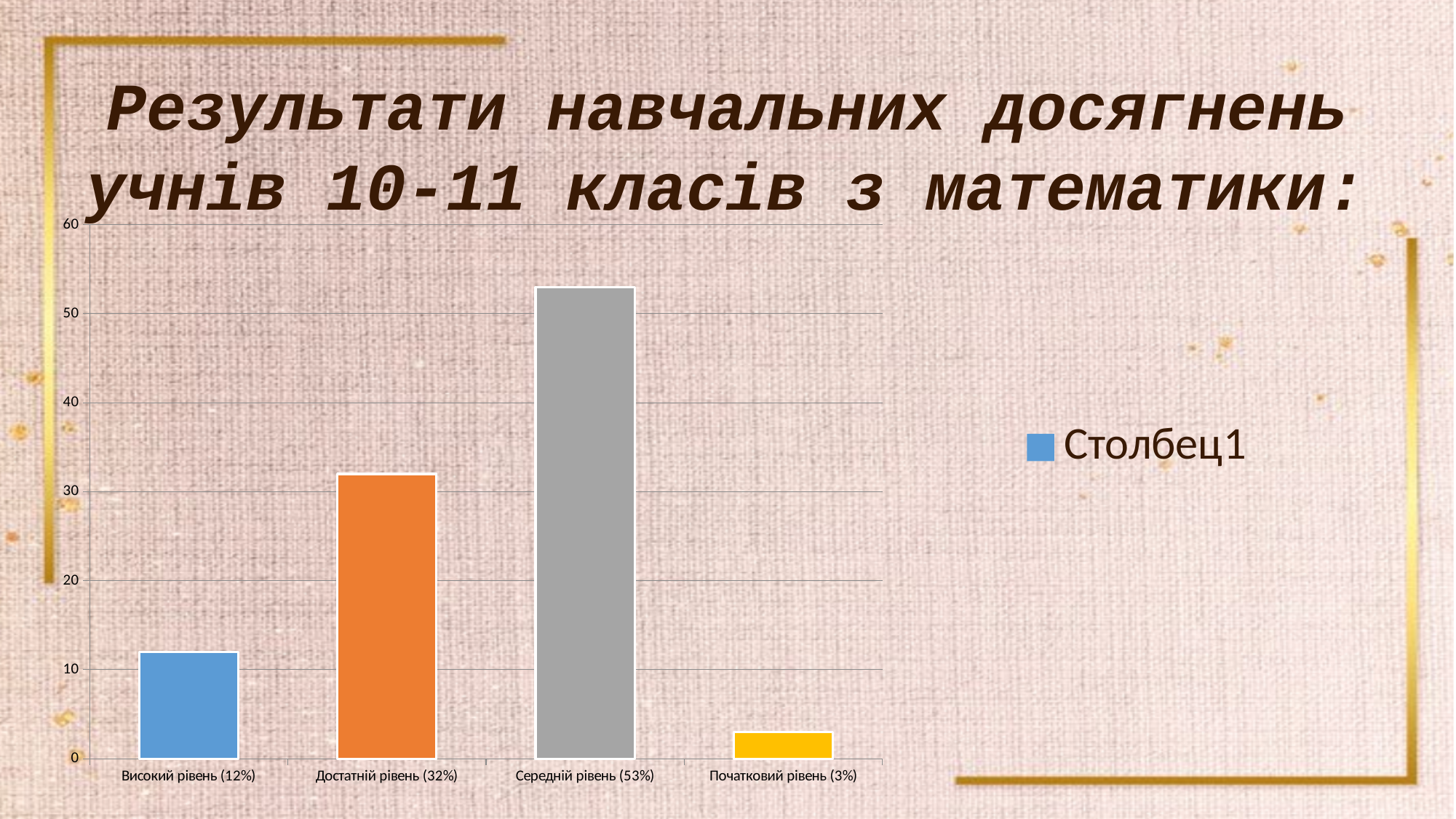
What kind of chart is shown on the slide? bar chart What percentage is shown for Початковий рівень? 3% What is the difference between the percentages for Середній рівень and Достатній рівень? 21% How many series does the chart legend list? 1 Which category has the lowest bar? Початковий рівень (3%) What percentage is shown for Високий рівень? 12% Which is larger, the value for Достатній рівень or the value for Високий рівень? Достатній рівень What is the name of the series in the chart legend? Столбец1 How many categories are shown on the x axis of the chart? 4 Is the value for Середній рівень greater or less than 50? greater What percentage is shown for Середній рівень? 53% Which category has the highest bar? Середній рівень (53%)